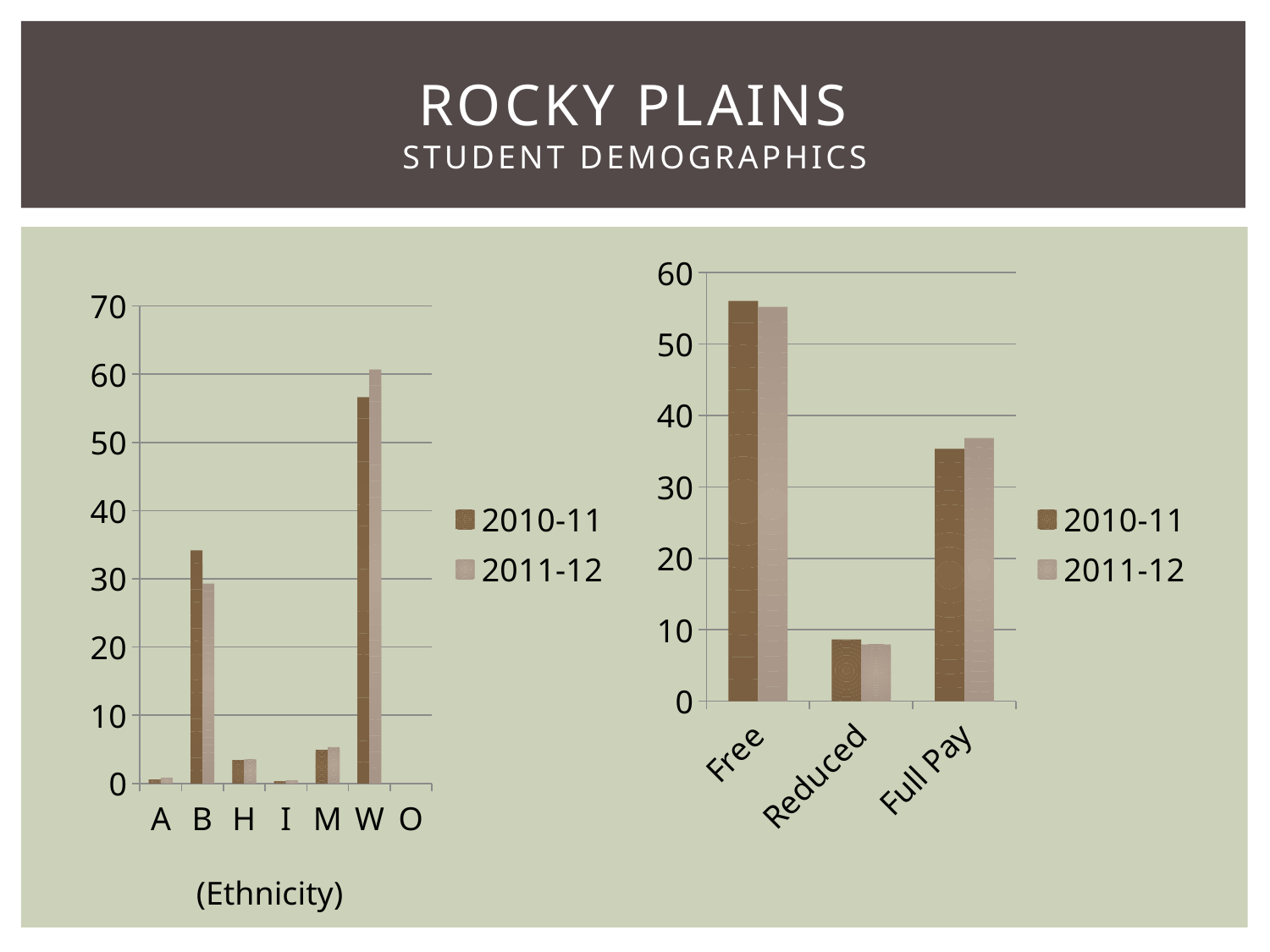
In the left (Ethnicity) chart, is the 2010-11 value for B greater or less than 30? greater How many categories are shown on the x axis of the left (Ethnicity) chart? 7 What kind of chart is the left chart labelled (Ethnicity)? bar chart In the right chart (Free / Reduced / Full Pay), is the 2010-11 value for Free greater or less than 50? greater How many series does the legend of the left (Ethnicity) chart list? 2 In the right chart (Free / Reduced / Full Pay), which category has the highest value for 2010-11? Free How many categories are shown on the x axis of the right chart (Free / Reduced / Full Pay)? 3 In the right chart (Free / Reduced / Full Pay), is the 2010-11 value for Full Pay greater or less than 40? less In the right chart (Free / Reduced / Full Pay), which category has the lowest value for 2011-12? Reduced In the left (Ethnicity) chart, which category has the highest value for 2010-11? W In the left (Ethnicity) chart, which is larger for category B: the 2010-11 value or the 2011-12 value? 2010-11